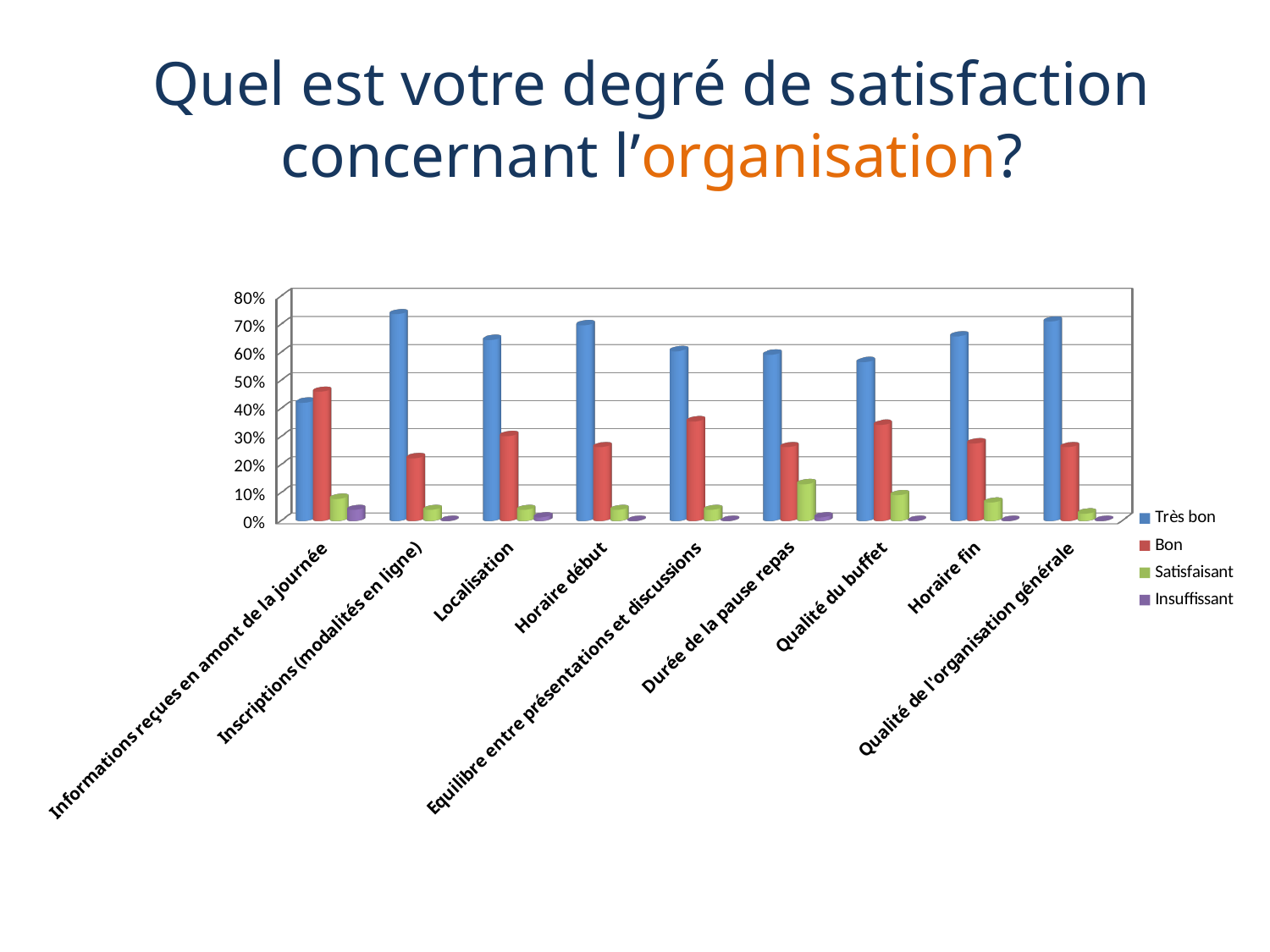
Is the 'Très bon' value for 'Informations reçues en amont de la journée' greater or less than 50%? less Is the 'Bon' value for 'Equilibre entre présentations et discussions' greater or less than 30%? greater Which category has the lowest value for the 'Très bon' series? Informations reçues en amont de la journée How many series does the legend list? 4 Which series is shown in blue in the legend? Très bon How many categories are shown on the x axis of the chart? 9 Is the 'Très bon' value for 'Qualité du buffet' greater or less than 50%? greater What kind of chart is shown on the slide? bar chart Which has the larger 'Très bon' value: 'Horaire début' or 'Qualité du buffet'? Horaire début Which category has the highest value for the 'Satisfaisant' series? Durée de la pause repas Which category has the highest value for the 'Bon' series? Informations reçues en amont de la journée